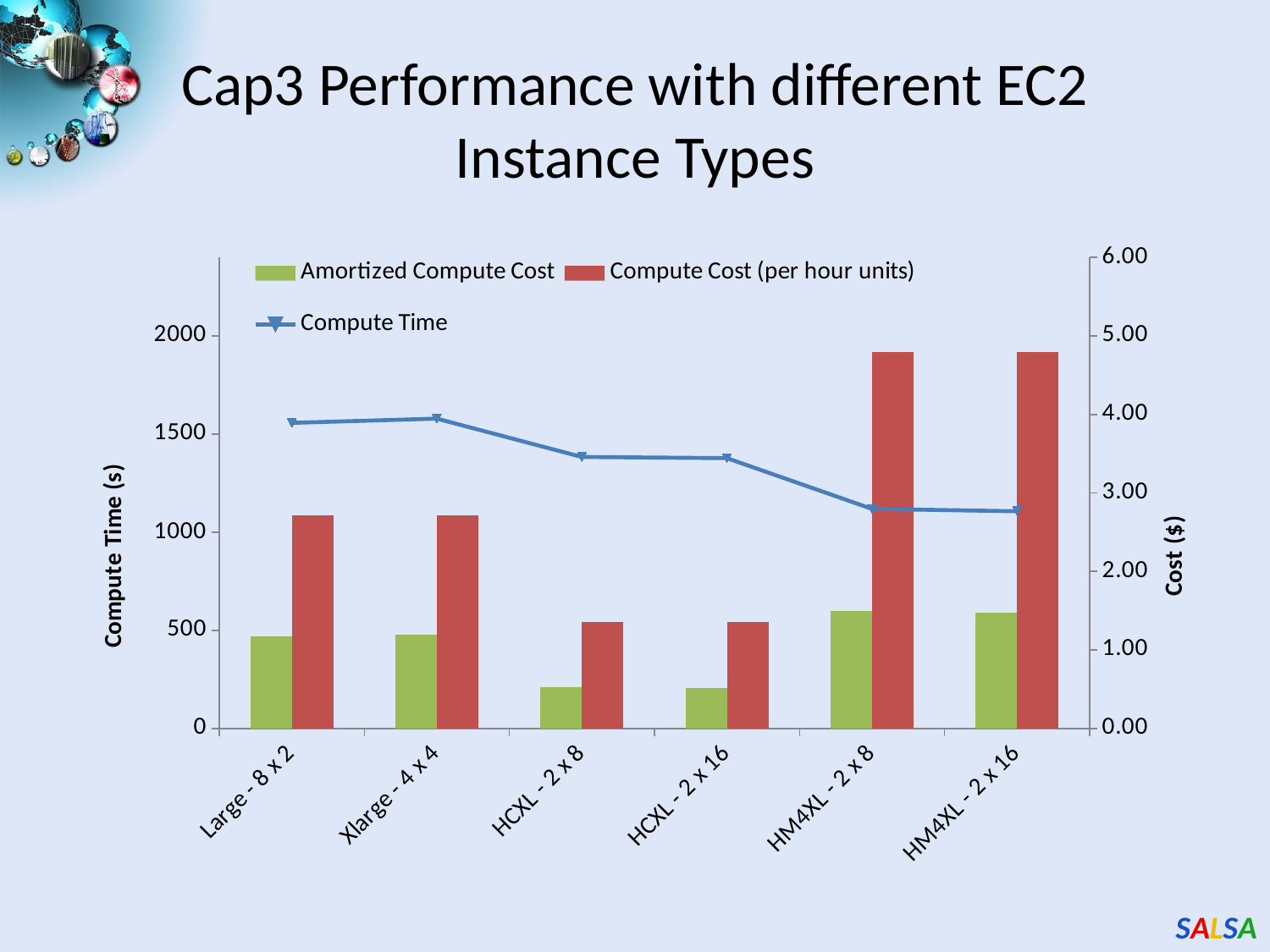
Which has the larger Compute Time: Large - 8 x 2 or HM4XL - 2 x 16? Large - 8 x 2 Is the Compute Cost (per hour units) for HM4XL - 2 x 16 greater or less than 4.00? greater Does the Compute Time line rise or fall from Large - 8 x 2 to HM4XL - 2 x 16? Falls How many series does the legend list? 3 How many EC2 instance types are shown along the x axis? 6 Is the Compute Time for HM4XL - 2 x 8 greater or less than 1000 s? greater What is the label of the right-hand vertical axis? Cost ($) Is the Compute Cost (per hour units) for HCXL - 2 x 16 greater or less than 2.00? less Which has the larger Compute Cost (per hour units): HM4XL - 2 x 8 or Large - 8 x 2? HM4XL - 2 x 8 What kind of chart is shown on the slide? A combined bar and line chart